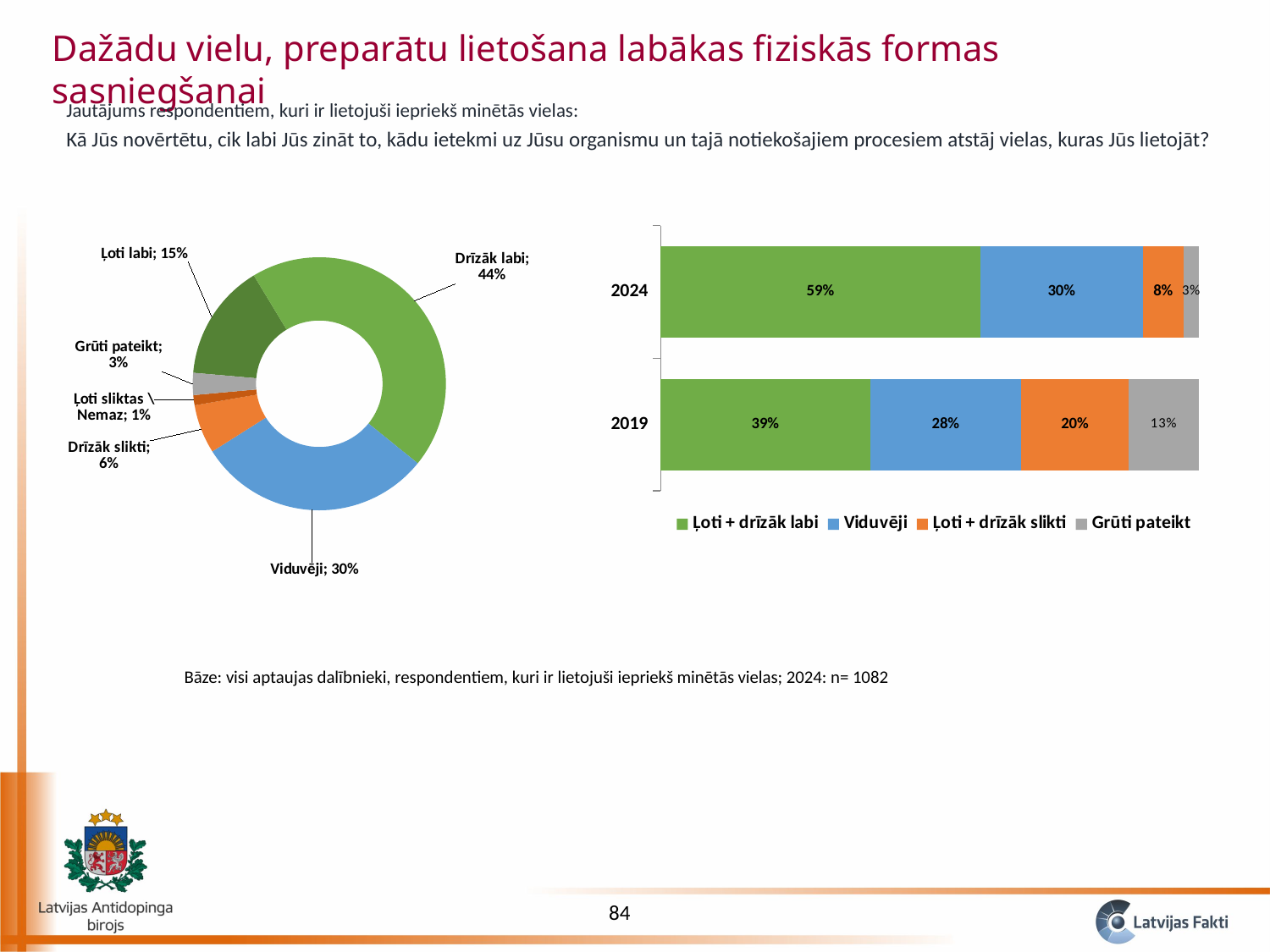
In the stacked bar chart on the right, how many series does the legend list? 4 What kind of chart is shown on the right side of the slide? Stacked bar chart In the donut chart on the left, how many categories are shown? 6 In the donut chart on the left, what share is labelled "Drīzāk labi"? 44% In the stacked bar chart on the right, what is the value for "Ļoti + drīzāk labi" in 2024? 59% In the stacked bar chart on the right, what is the value for "Ļoti + drīzāk slikti" in 2024? 8% In the donut chart on the left, which category has the smallest share? Ļoti sliktas \ Nemaz In the stacked bar chart on the right, which year has the larger value for "Ļoti + drīzāk labi", 2024 or 2019? 2024 In the donut chart on the left, which category has the largest share? Drīzāk labi In the stacked bar chart on the right, what is the value for "Grūti pateikt" in 2019? 13% In the donut chart on the left, what share is labelled "Viduvēji"? 30% In the donut chart on the left, what is the difference between the shares for "Drīzāk labi" and "Ļoti labi"? 29%